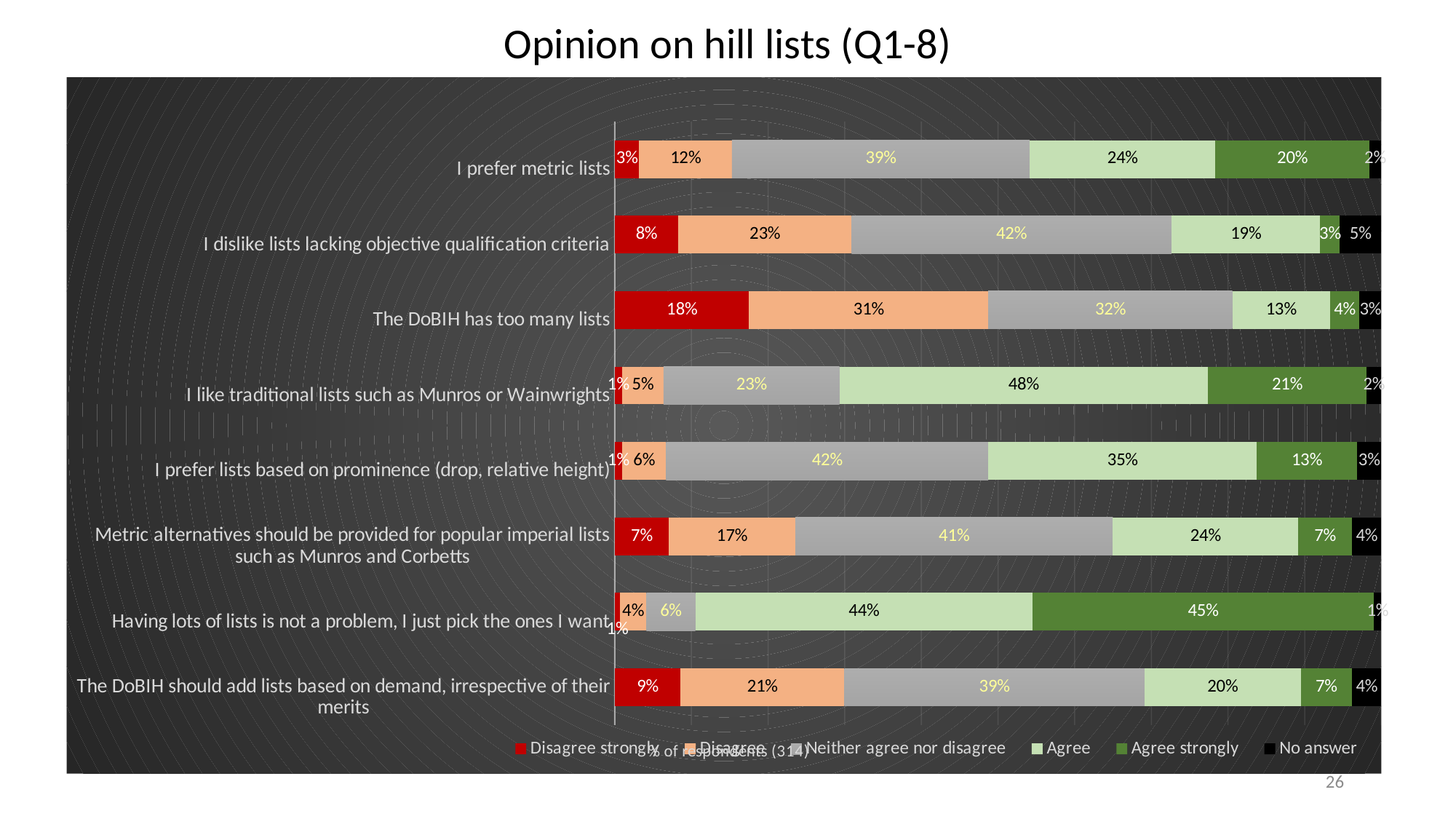
Which is larger: the 'Agree strongly' value for 'I prefer metric lists' or for 'Metric alternatives should be provided for popular imperial lists such as Munros and Corbetts'? I prefer metric lists How many series does the legend list? 6 What type of chart is shown on the slide? Stacked bar chart What percentage of respondents 'Agree strongly' with 'Having lots of lists is not a problem, I just pick the ones I want'? 45% How many statements (categories) are plotted in the chart? 8 Which statement has the highest 'Agree' percentage? I like traditional lists such as Munros or Wainwrights What is the 'Neither agree nor disagree' value for 'I dislike lists lacking objective qualification criteria'? 42% What is the difference between the 'Agree' and 'Agree strongly' values for 'I prefer lists based on prominence (drop, relative height)'? 22% What is the 'No answer' value for 'The DoBIH should add lists based on demand, irrespective of their merits'? 4% What is the 'Disagree' value for 'The DoBIH has too many lists'? 31% What is the title of the chart? Opinion on hill lists (Q1-8) Which statement has the highest 'Disagree strongly' percentage? The DoBIH has too many lists